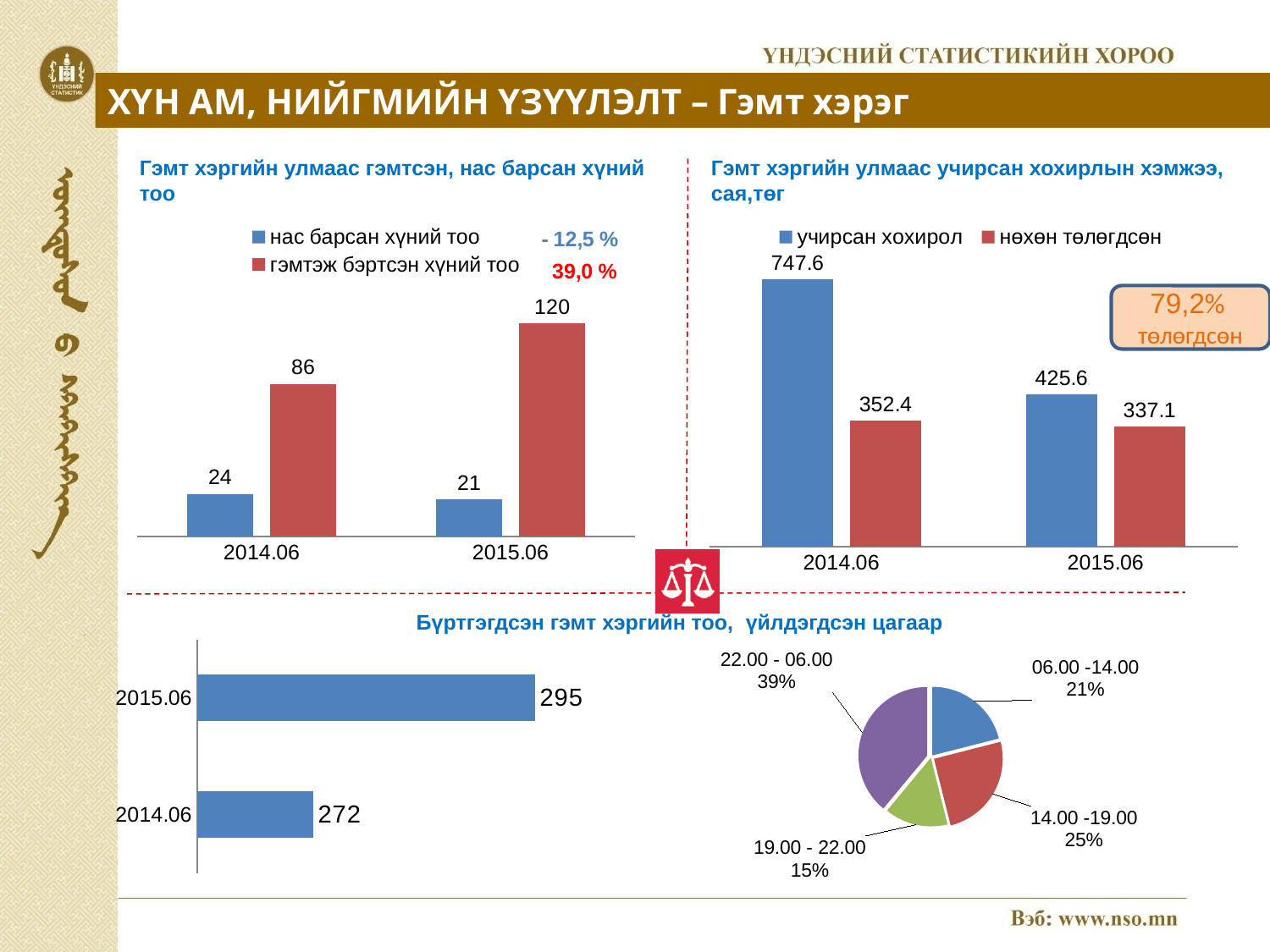
In the top-right chart 'Гэмт хэргийн улмаас учирсан хохирлын хэмжээ, сая,төг', what is the value for 'учирсан хохирол' in 2014.06? 747.6 In the top-left chart 'Гэмт хэргийн улмаас гэмтсэн, нас барсан хүний тоо', what is the value for 'гэмтэж бэртсэн хүний тоо' in 2015.06? 120 In the top-right chart 'Гэмт хэргийн улмаас учирсан хохирлын хэмжээ, сая,төг', what is the value for 'нөхөн төлөгдсөн' in 2015.06? 337.1 In the top-left chart 'Гэмт хэргийн улмаас гэмтсэн, нас барсан хүний тоо', what is the value for 'нас барсан хүний тоо' in 2014.06? 24 In the bottom-left bar chart under 'Бүртгэгдсэн гэмт хэргийн тоо, үйлдэгдсэн цагаар', what is the value for 2015.06? 295 In the bottom-right pie chart, which time period has the largest share? 22.00 - 06.00 In the top-right chart 'Гэмт хэргийн улмаас учирсан хохирлын хэмжээ, сая,төг', what is the difference between 'учирсан хохирол' and 'нөхөн төлөгдсөн' in 2015.06? 88.5 How many series does the legend of the top-left chart 'Гэмт хэргийн улмаас гэмтсэн, нас барсан хүний тоо' list? 2 In the bottom-left bar chart under 'Бүртгэгдсэн гэмт хэргийн тоо, үйлдэгдсэн цагаар', what is the difference between the 2015.06 and 2014.06 values? 23 In the top-right chart 'Гэмт хэргийн улмаас учирсан хохирлын хэмжээ, сая,төг', which is larger: 'учирсан хохирол' in 2014.06 or in 2015.06? 2014.06 In the top-left chart 'Гэмт хэргийн улмаас гэмтсэн, нас барсан хүний тоо', what is the difference between 'гэмтэж бэртсэн хүний тоо' in 2015.06 and in 2014.06? 34 In the bottom-right pie chart, what share does '19.00 - 22.00' have? 15%